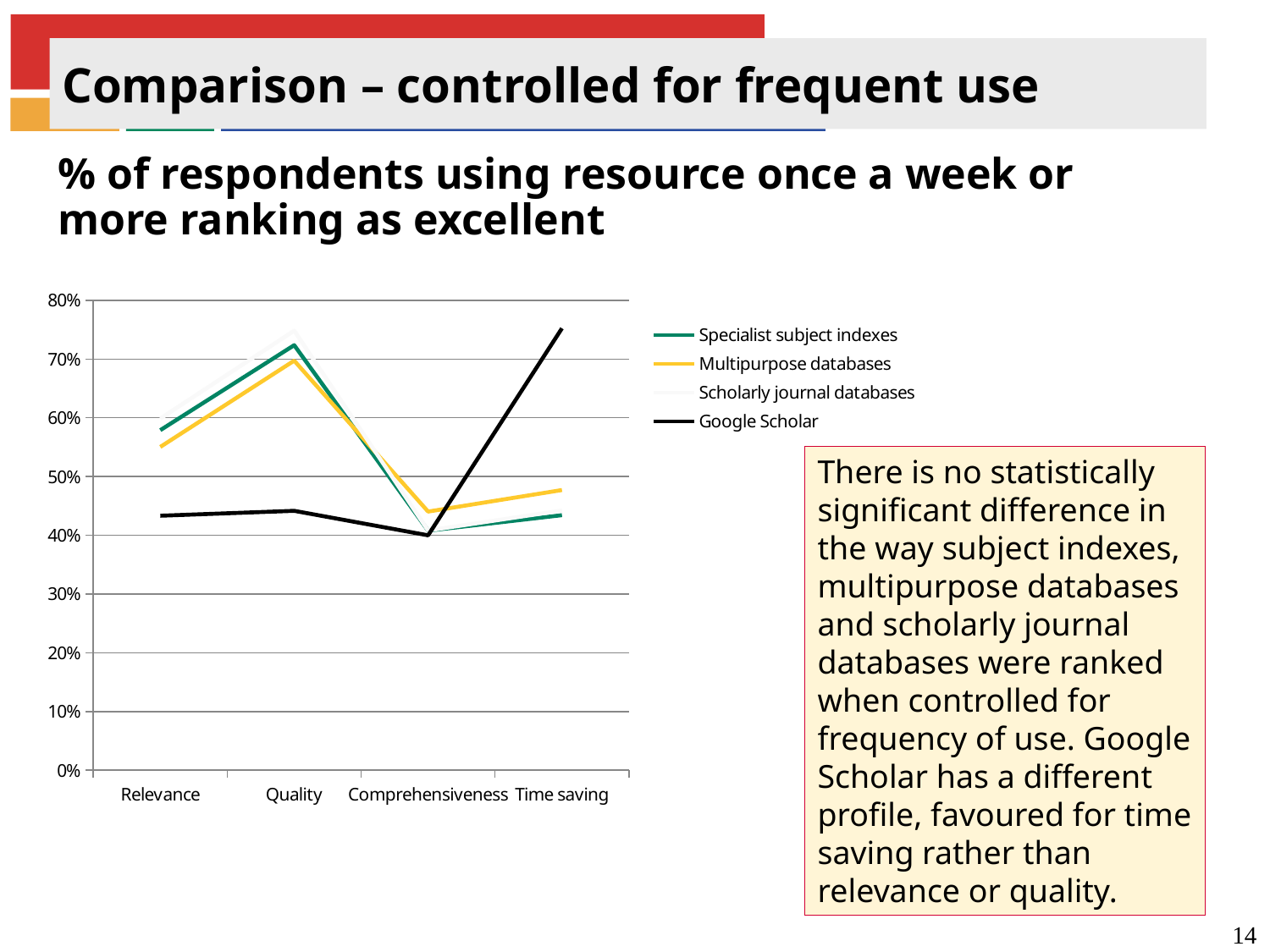
How many categories are shown along the x axis of the chart? 4 What is the title of the chart? % of respondents using resource once a week or more ranking as excellent For the Google Scholar series, which category has the highest value? Time saving Is the value for Google Scholar at Relevance greater or less than 50%? less Is the value for Specialist subject indexes at Quality greater or less than 60%? greater Is the value for Multipurpose databases at Relevance greater or less than 50%? greater At Time saving, which series has the higher value: Google Scholar or Multipurpose databases? Google Scholar How many series does the chart legend list? 4 Does the Google Scholar line rise or fall from Comprehensiveness to Time saving? rise What kind of chart is shown on the slide? line chart At Relevance, which series has the higher value: Specialist subject indexes or Google Scholar? Specialist subject indexes